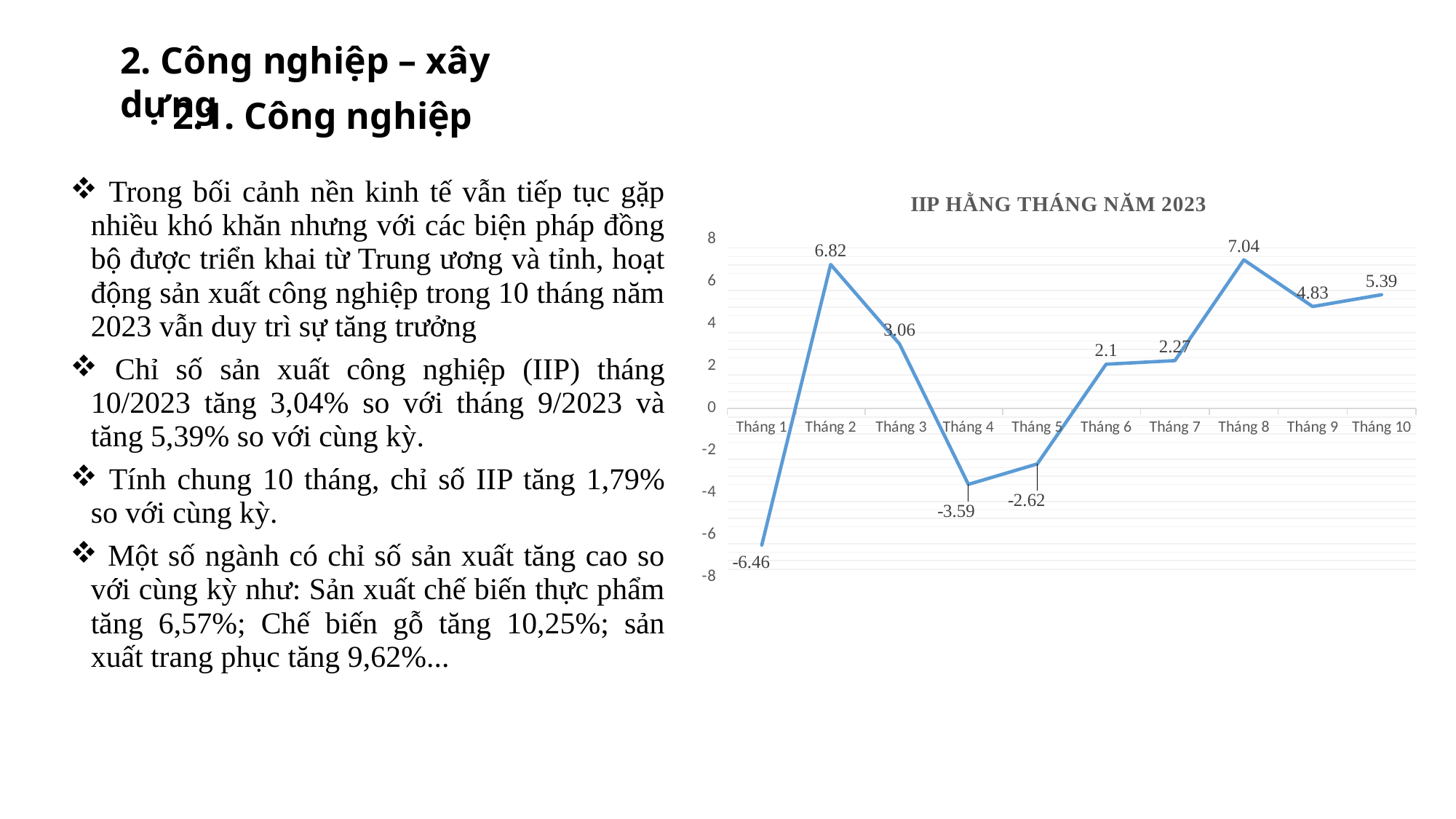
What is the value for Tháng 8? 7.04 Does the value rise or fall from Tháng 3 to Tháng 4? fall What is the value for Tháng 1? -6.46 Which month has the lowest value? Tháng 1 Which month has the highest value? Tháng 8 Which is larger, the value for Tháng 9 or the value for Tháng 10? Tháng 10 What is the difference between the values for Tháng 8 and Tháng 2? 0.22 What is the value for Tháng 5? -2.62 What type of chart is shown on the slide? line chart How many months are plotted on the chart? 10 Is the value for Tháng 4 greater or less than -2? less What is the title of the chart? IIP HẰNG THÁNG NĂM 2023